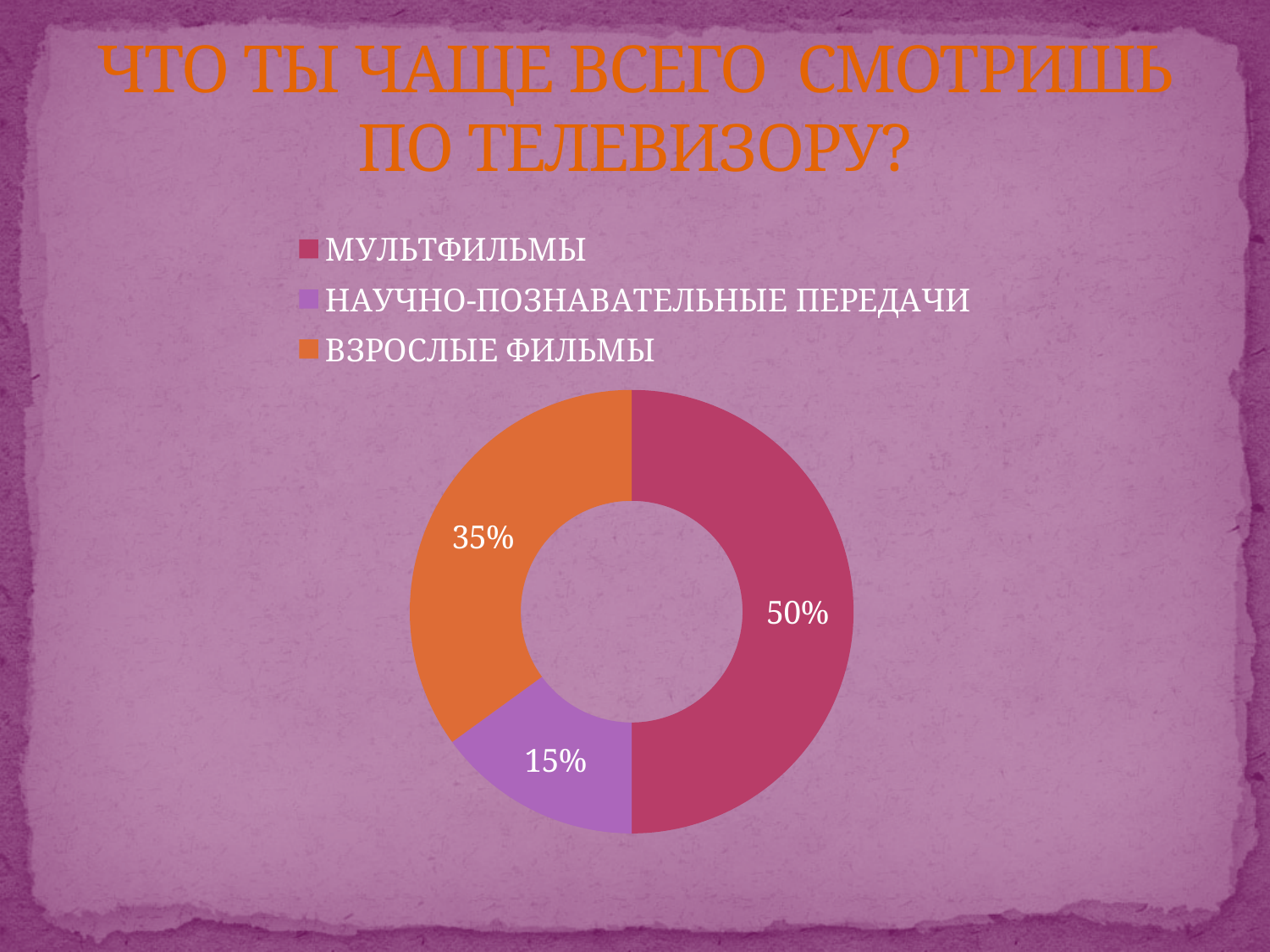
What colour is the slice for ВЗРОСЛЫЕ ФИЛЬМЫ? Orange How many categories does the chart show? 3 What is the difference in percentage points between ВЗРОСЛЫЕ ФИЛЬМЫ and НАУЧНО-ПОЗНАВАТЕЛЬНЫЕ ПЕРЕДАЧИ? 20 Which category has the largest share? МУЛЬТФИЛЬМЫ What is the difference in percentage points between МУЛЬТФИЛЬМЫ and ВЗРОСЛЫЕ ФИЛЬМЫ? 15 What is the title of the slide? ЧТО ТЫ ЧАЩЕ ВСЕГО СМОТРИШЬ ПО ТЕЛЕВИЗОРУ? What kind of chart is shown on the slide? Doughnut chart Which category has the smallest share? НАУЧНО-ПОЗНАВАТЕЛЬНЫЕ ПЕРЕДАЧИ Which is larger, the share for ВЗРОСЛЫЕ ФИЛЬМЫ or for НАУЧНО-ПОЗНАВАТЕЛЬНЫЕ ПЕРЕДАЧИ? ВЗРОСЛЫЕ ФИЛЬМЫ What share of the chart is НАУЧНО-ПОЗНАВАТЕЛЬНЫЕ ПЕРЕДАЧИ? 15% What share of the chart is ВЗРОСЛЫЕ ФИЛЬМЫ? 35% What share of the chart is МУЛЬТФИЛЬМЫ? 50%